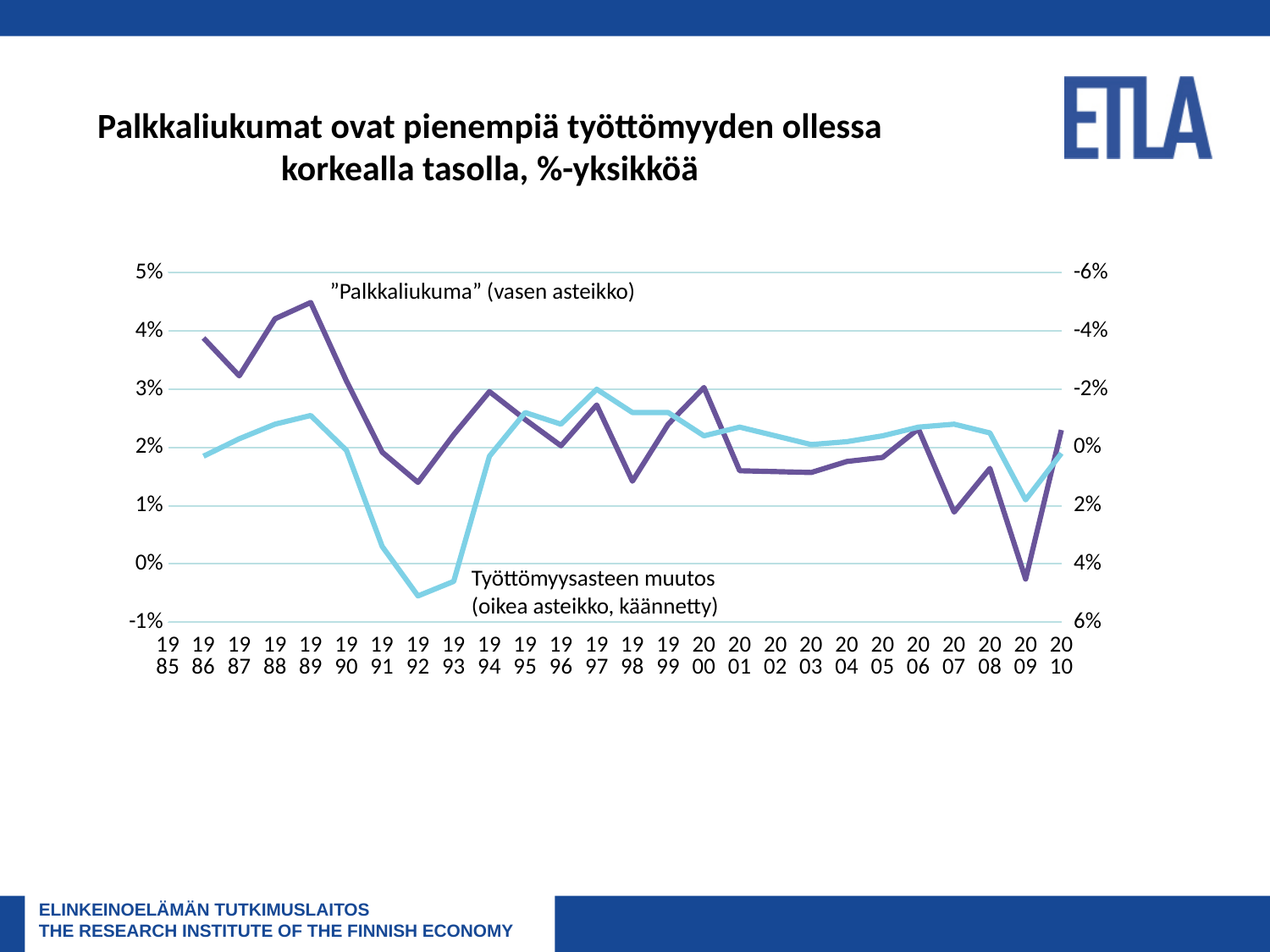
Which series is plotted on the right-hand (inverted) axis? Työttömyysasteen muutos In which year does the "Palkkaliukuma" series reach its lowest value? 2009 Is the "Palkkaliukuma" value for 1989 greater or less than 4%? greater Is the "Palkkaliukuma" value for 1992 greater or less than 2%? less How many year labels are shown on the x axis of the chart? 26 What kind of chart is shown on the slide? line chart Which year has the larger "Palkkaliukuma" value, 1988 or 1992? 1988 Is the "Palkkaliukuma" value for 2009 greater or less than 0%? less Does the "Palkkaliukuma" series rise or fall between 1989 and 1992? fall How many series are plotted in the chart? 2 In which year does the "Palkkaliukuma" series reach its highest value? 1989 What is the title of the chart on the slide? Palkkaliukumat ovat pienempiä työttömyyden ollessa korkealla tasolla, %-yksikköä